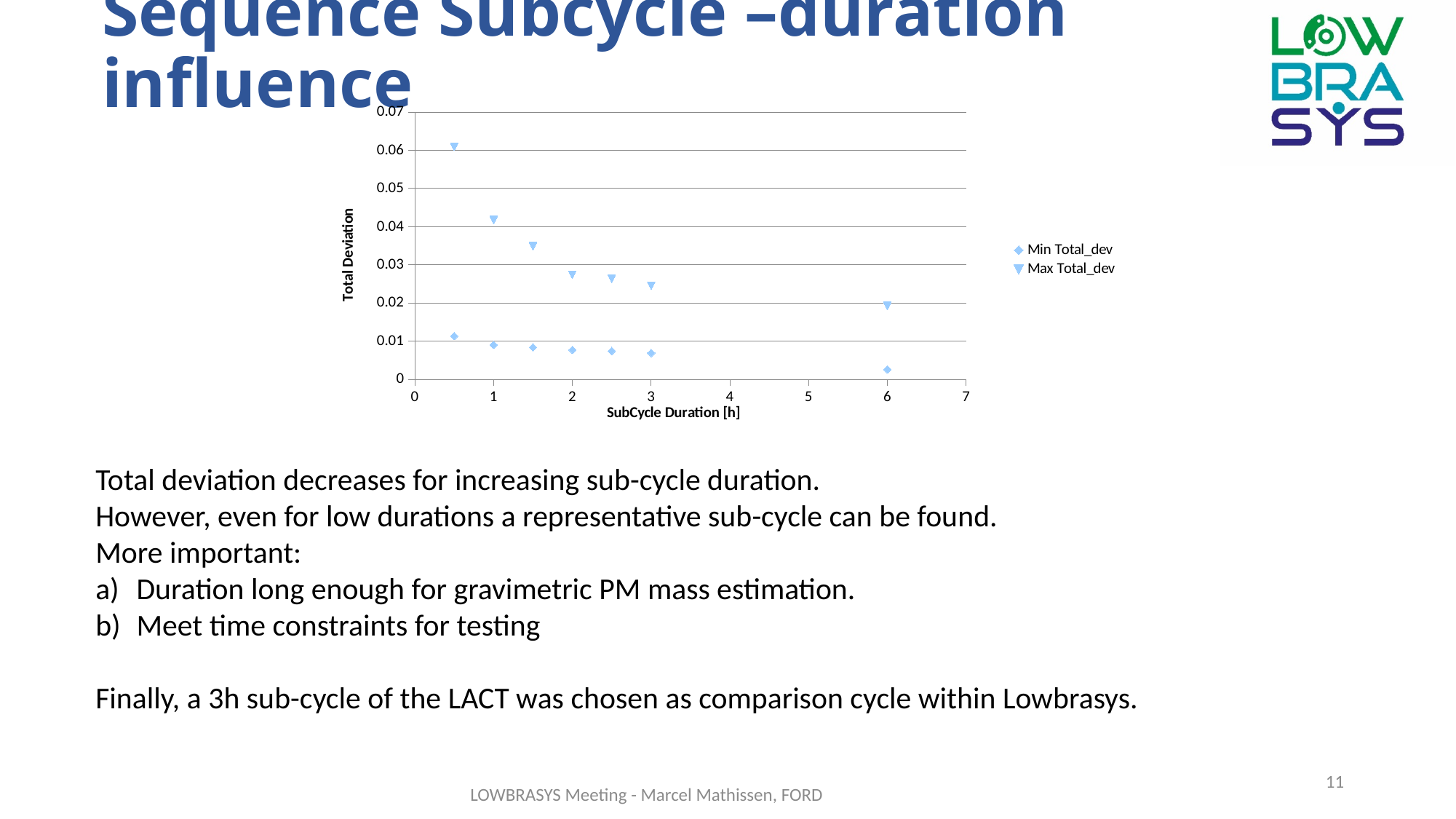
At which SubCycle Duration is the Min Total_dev value lowest? 6 Is the Max Total_dev value at a SubCycle Duration of 3 h greater or less than 0.03? less What kind of chart is shown on the slide? scatter chart Does the Max Total_dev series rise or fall as SubCycle Duration increases? fall Is the Min Total_dev value at a SubCycle Duration of 6 h greater or less than 0.01? less How many data points are plotted for the Max Total_dev series? 7 What is the title of the x axis of the chart? SubCycle Duration [h] At which SubCycle Duration is the Max Total_dev value highest? 0.5 At a SubCycle Duration of 3 h, which series has the larger value, Min Total_dev or Max Total_dev? Max Total_dev Is the Max Total_dev value at a SubCycle Duration of 0.5 h greater or less than 0.05? greater How many series does the chart legend list? 2